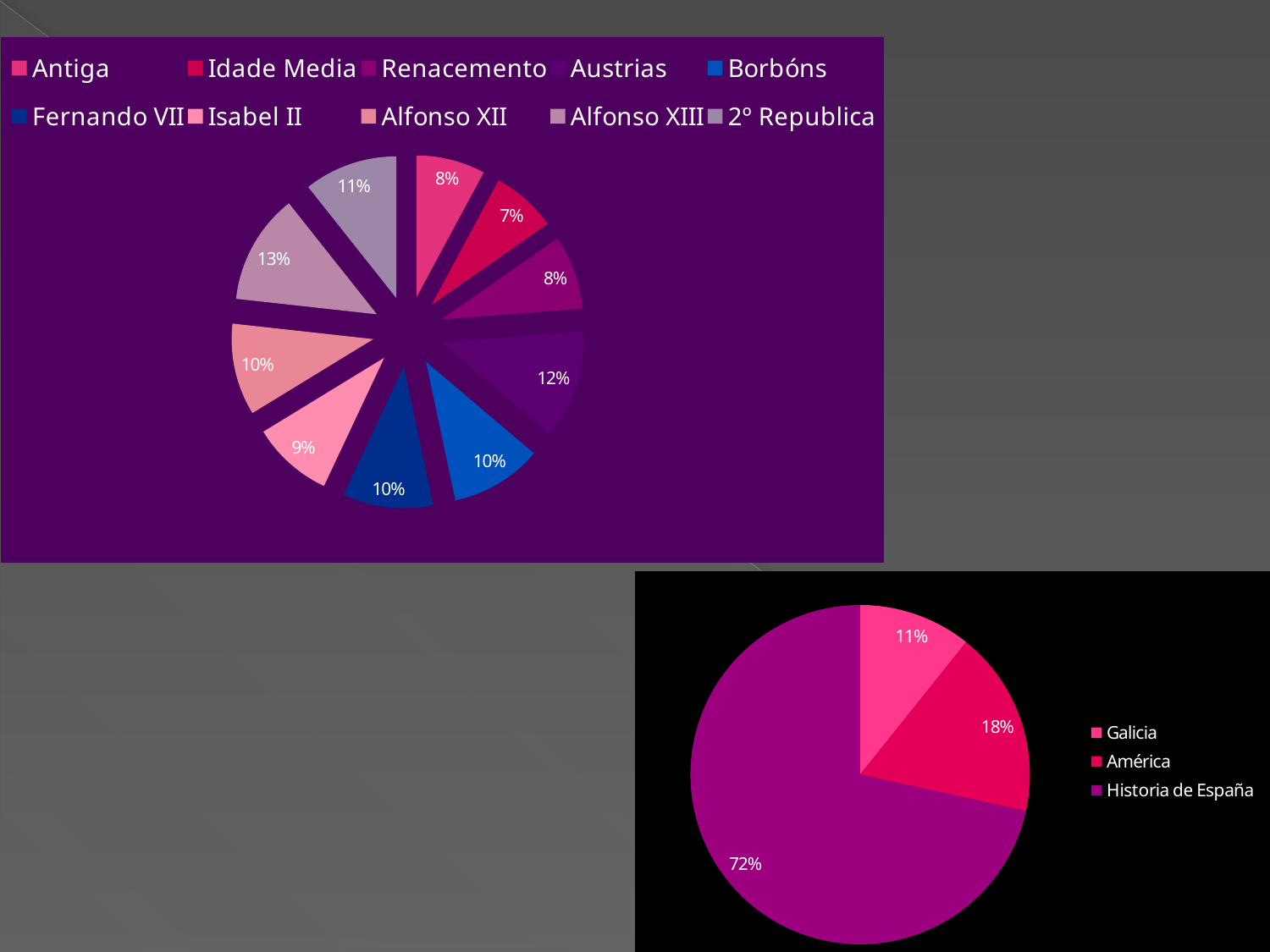
In the top-left pie chart, how many categories does the legend list? 10 In the top-left pie chart, which category has the smallest slice? Idade Media In the bottom-right pie chart, what share does Galicia have? 11% In the bottom-right pie chart, which is larger, América or Galicia? América In the top-left pie chart, what share does Alfonso XIII have? 13% In the bottom-right pie chart, what share does Historia de España have? 72% What type of chart is the bottom-right chart? Pie chart In the top-left pie chart, what share does Idade Media have? 7% In the top-left pie chart, which category has the largest slice? Alfonso XIII In the top-left pie chart, what is the difference between the shares of Alfonso XIII and Idade Media? 6% In the top-left pie chart, what share does Austrias have? 12% In the bottom-right pie chart, how many slices are there? 3